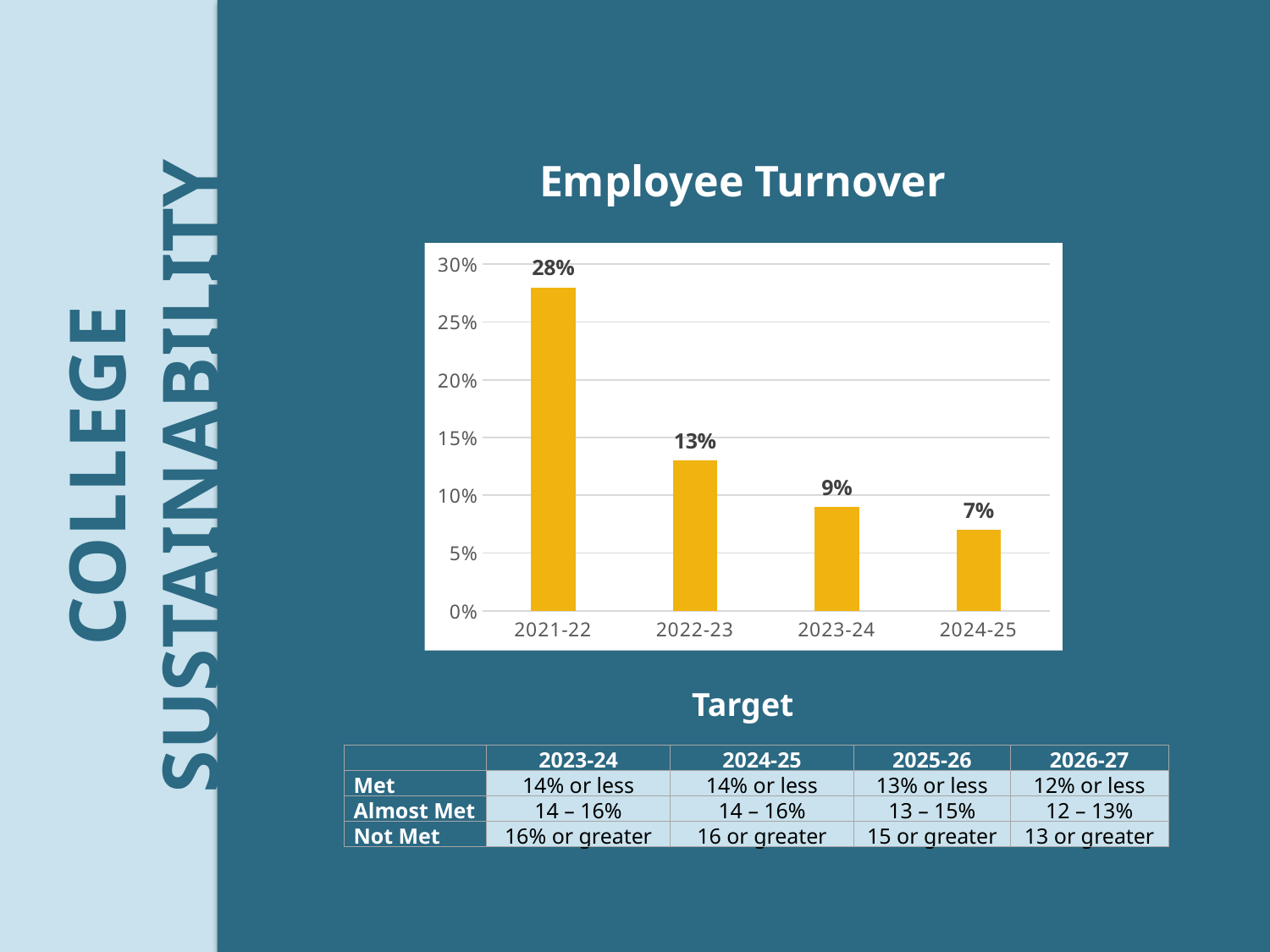
Does employee turnover rise or fall from 2021-22 to 2024-25? Fall What is the employee turnover value for 2021-22? 28% What is the employee turnover value for 2022-23? 13% Which year has the highest employee turnover? 2021-22 How many years are shown on the Employee Turnover chart? 4 What is the difference in employee turnover between 2021-22 and 2022-23? 15% Which year has a higher employee turnover, 2022-23 or 2023-24? 2022-23 Is the employee turnover value for 2021-22 greater or less than 25%? greater What is the employee turnover value for 2024-25? 7% What kind of chart is used to show Employee Turnover? Bar chart What is the difference in employee turnover between 2023-24 and 2024-25? 2% Which year has the lowest employee turnover? 2024-25